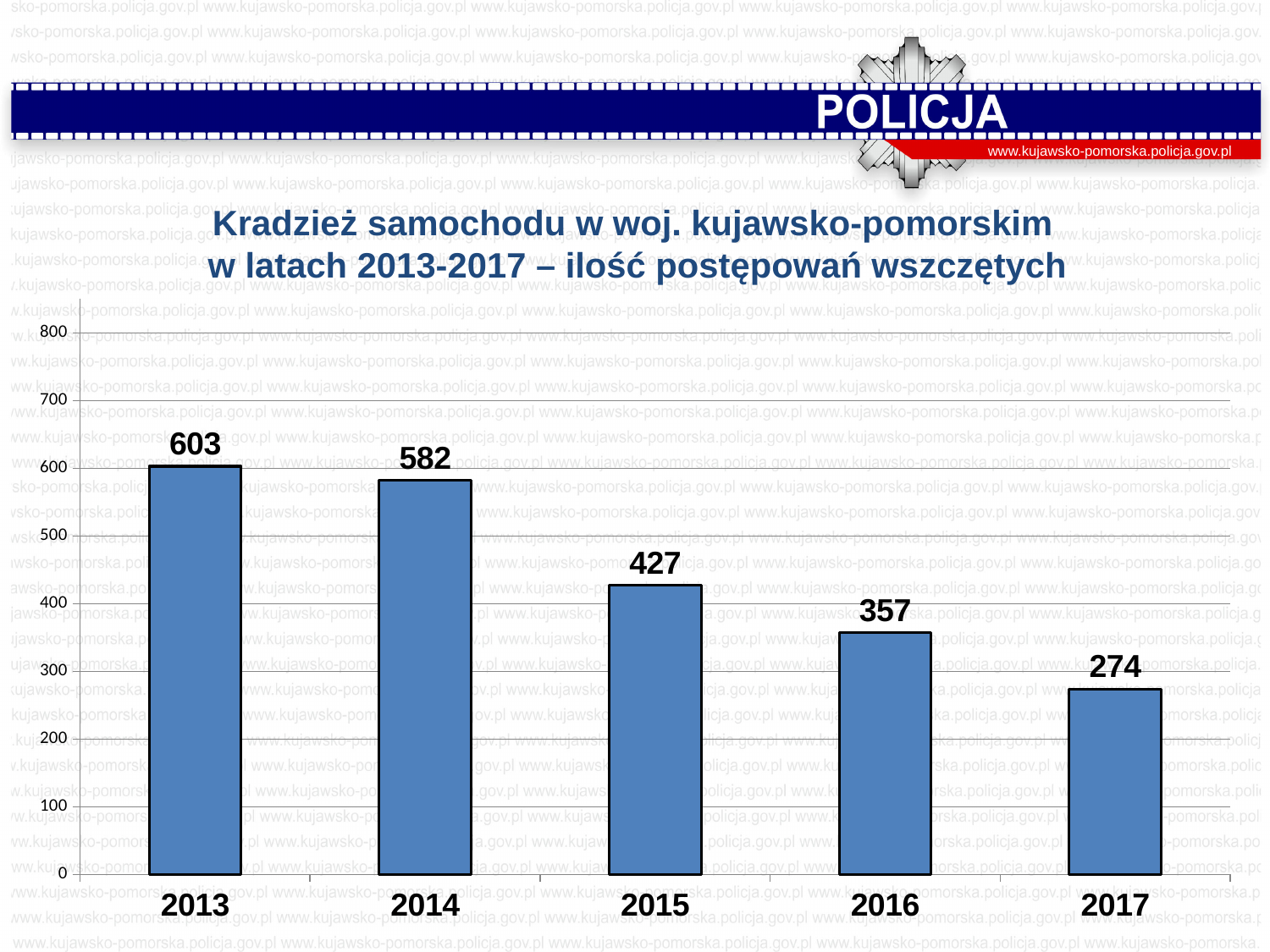
Do the values rise or fall from 2013 to 2017? fall Is the value for 2016 greater or less than 400? less What kind of chart is shown on the slide? bar chart How many years are shown on the x axis? 5 Which year has the highest value? 2013 Which year has the lowest value? 2017 What is the value for 2013? 603 What is the value for 2017? 274 What is the value for 2015? 427 What is the difference between the values for 2013 and 2017? 329 Which is larger, the value for 2015 or the value for 2016? 2015 What is the difference between the values for 2014 and 2015? 155